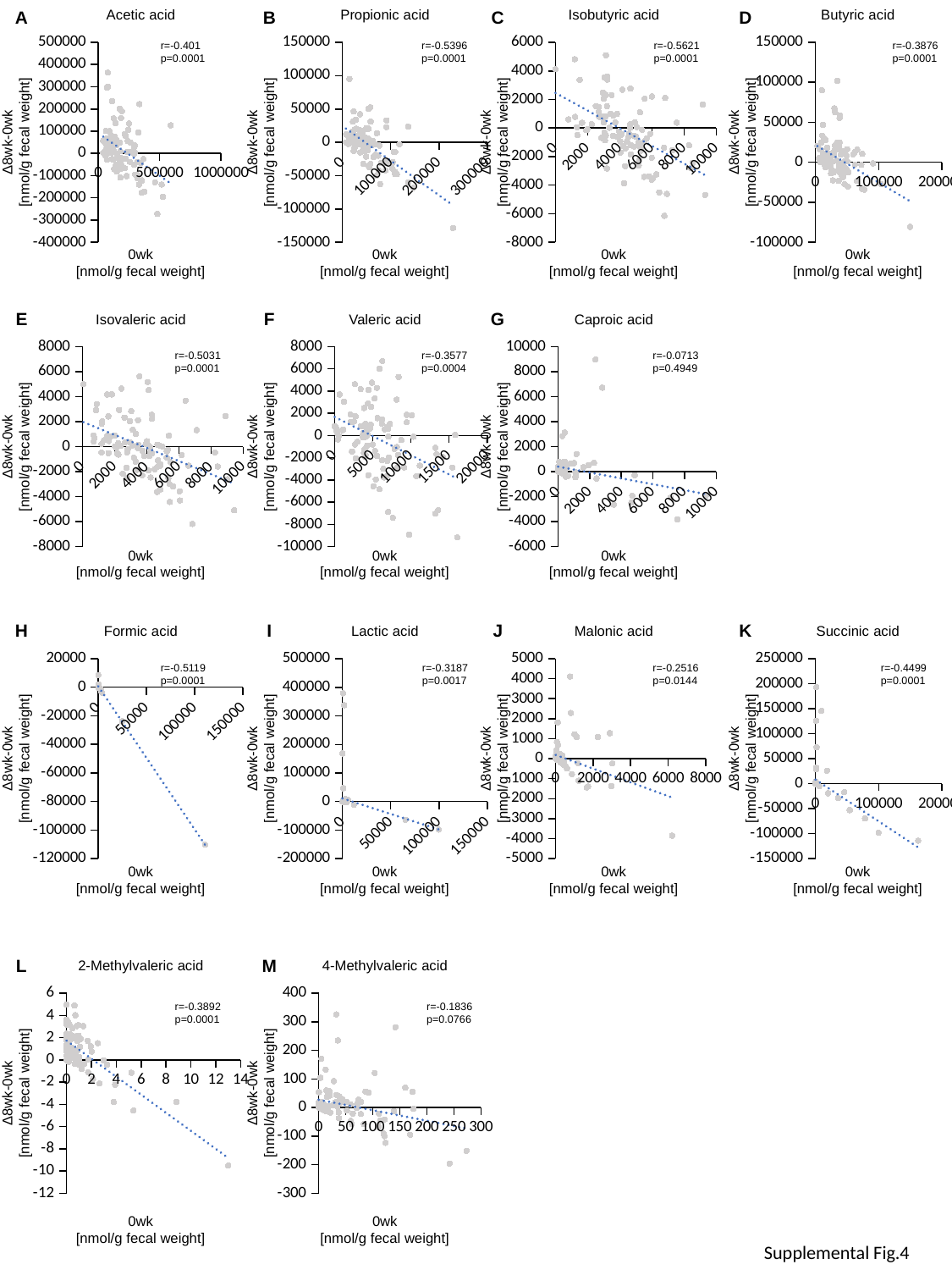
What is the y-axis label used on the charts? Δ8wk-0wk [nmol/g fecal weight] What is the p value printed on the Caproic acid chart (panel G)? p=0.4949 What is the x-axis label used on the charts? 0wk [nmol/g fecal weight] What is the r value printed on the 2-Methylvaleric acid chart (panel L)? r=-0.3892 What type of chart is panel A (Acetic acid)? scatter plot What is the r value printed on the Propionic acid chart (panel B)? r=-0.5396 Which panel shows the r value closest to zero? Caproic acid (G), r=-0.0713 In the Succinic acid chart (panel K), does the dotted trend line rise or fall as the 0wk value increases? fall Which has the more negative r value, the Valeric acid chart or the Isovaleric acid chart? Isovaleric acid What is the p value printed on the 4-Methylvaleric acid chart (panel M)? p=0.0766 How many chart panels are shown on the slide? 13 Which panel shows the most negative r value? Isobutyric acid (C), r=-0.5621